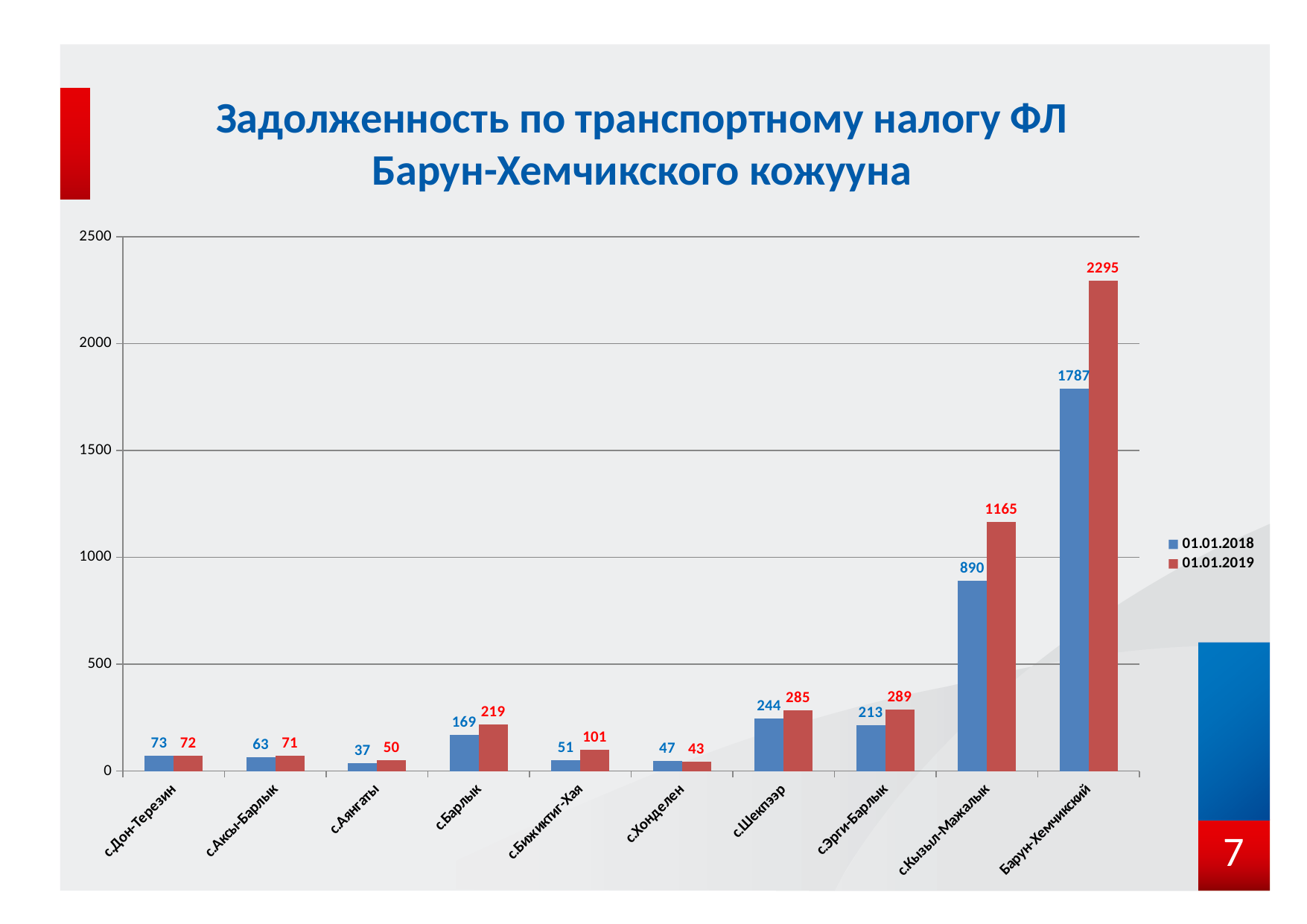
What is the difference between the 01.01.2019 and 01.01.2018 values for с.Эрги-Барлык? 76 Which category has the lowest value in the 01.01.2018 series? с.Аянгаты What kind of chart is shown on the slide? bar chart How many categories are shown on the x axis? 10 For с.Хонделен, which series has the larger value, 01.01.2018 or 01.01.2019? 01.01.2018 What is the difference between the 01.01.2019 and 01.01.2018 values for Барун-Хемчикский? 508 How many series does the legend list? 2 Which category has the highest value in the 01.01.2019 series? Барун-Хемчикский Is the 01.01.2018 value for с.Кызыл-Мажалык greater or less than 1000? less What is the value for с.Барлык in the 01.01.2018 series? 169 What is the value for с.Кызыл-Мажалык in the 01.01.2019 series? 1165 What is the value for с.Бижиктиг-Хая in the 01.01.2019 series? 101